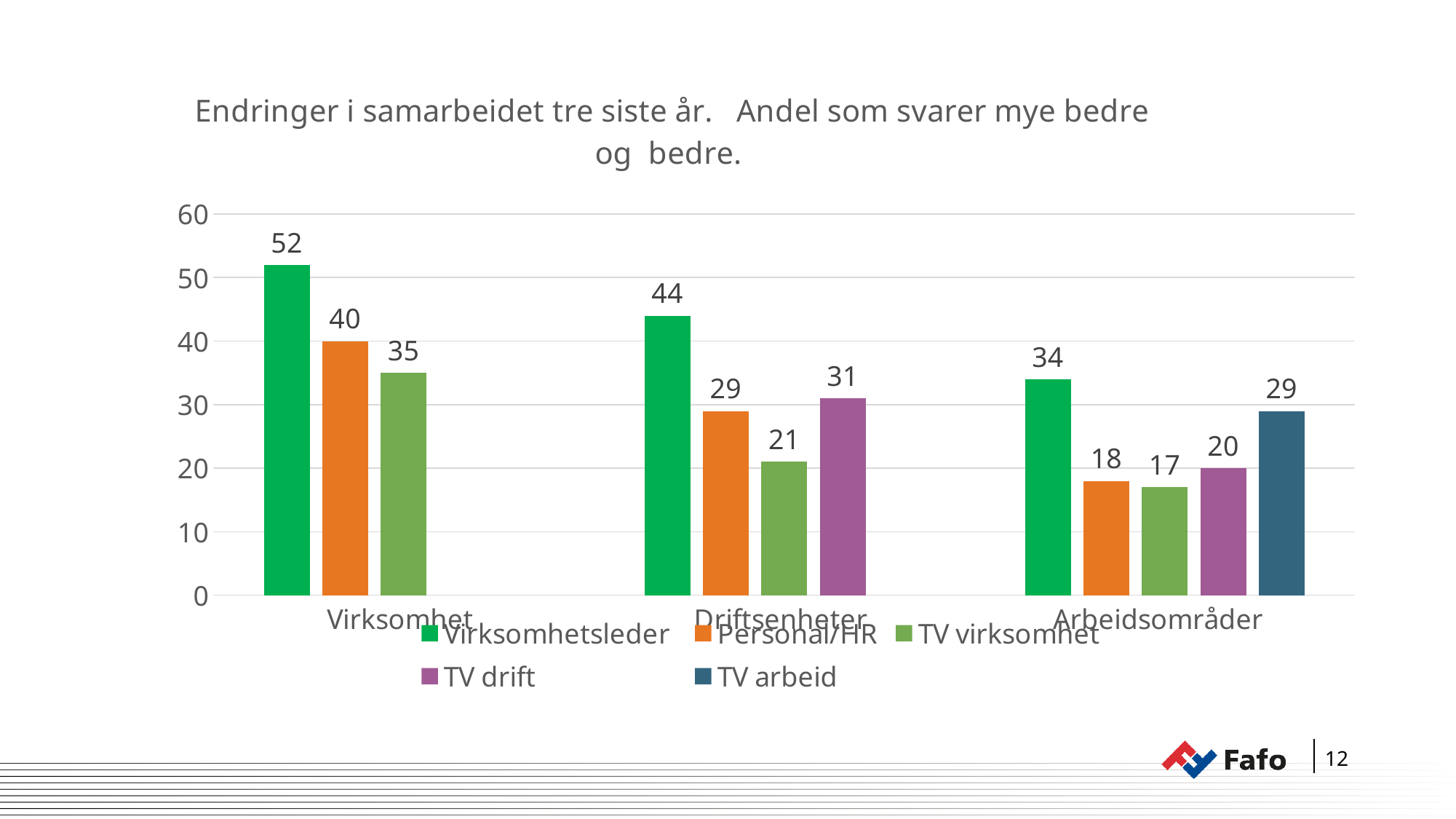
How many series does the legend list? 5 How many categories are shown on the x axis? 3 Which is larger: TV virksomhet in Virksomhet or TV virksomhet in Driftsenheter? TV virksomhet in Virksomhet What is the value for TV drift in the Driftsenheter category? 31 What kind of chart is shown on the slide? Bar chart What is the value for Personal/HR in the Arbeidsområder category? 18 Which series has the lowest value in the Arbeidsområder category? TV virksomhet What is the difference between the Virksomhetsleder and Personal/HR values in the Virksomhet category? 12 What is the value for Virksomhetsleder in the Virksomhet category? 52 Do the Virksomhetsleder values rise or fall from Virksomhet to Arbeidsområder? Fall What is the value for TV arbeid in the Arbeidsområder category? 29 Which series has the highest value in the Driftsenheter category? Virksomhetsleder